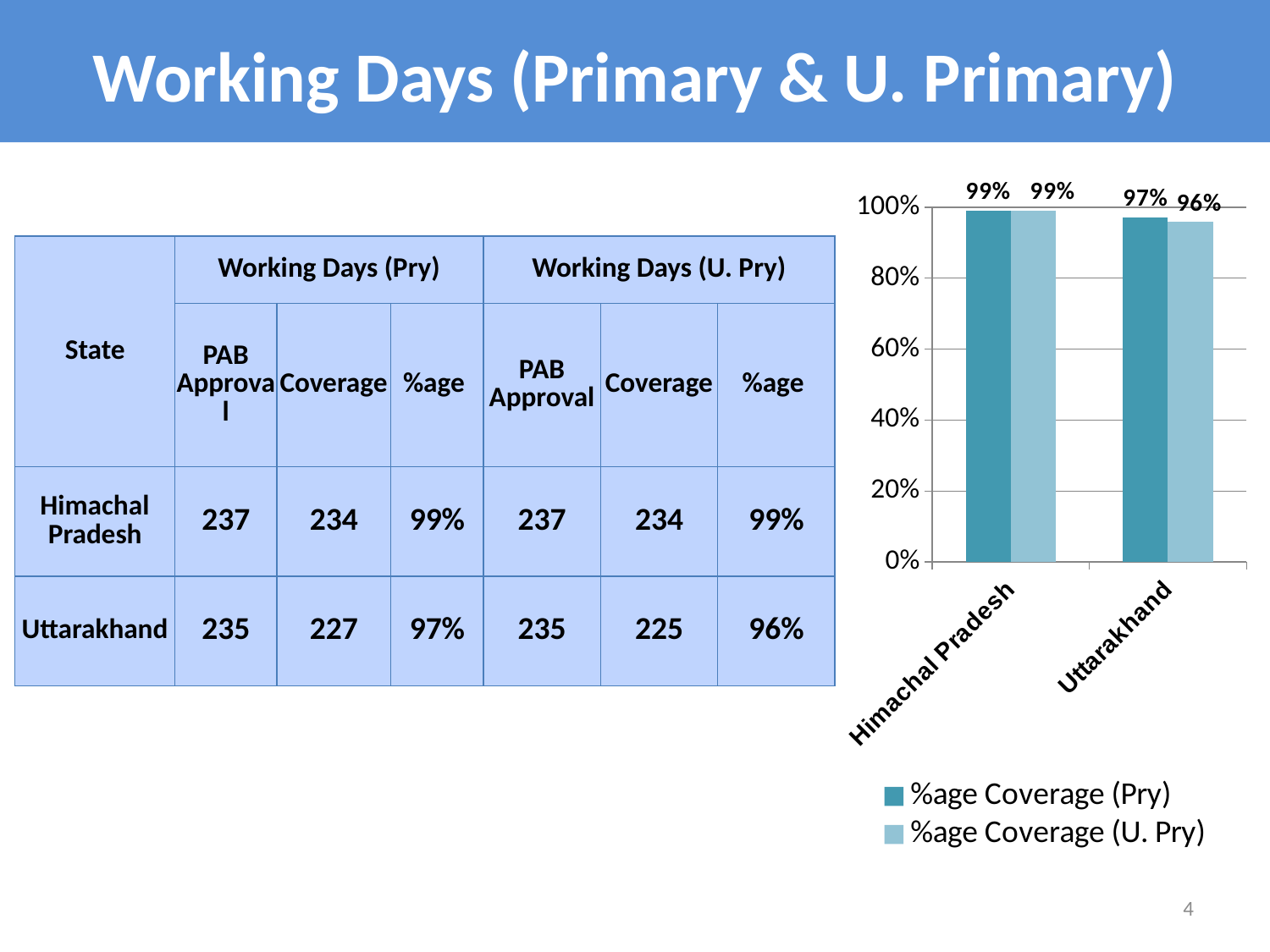
What is the %age Coverage (Pry) for Uttarakhand in the chart? 97% How many states are shown on the x axis of the chart? 2 Which state has the lower %age Coverage (U. Pry) in the chart? Uttarakhand What is the %age Coverage (Pry) for Himachal Pradesh in the chart? 99% How many series does the chart legend list? 2 Which is larger for Uttarakhand: %age Coverage (Pry) or %age Coverage (U. Pry)? %age Coverage (Pry) What type of chart is shown on the slide? bar chart What is the highest value labelled on the chart's y axis? 100% What is the difference between the %age Coverage (Pry) for Himachal Pradesh and Uttarakhand? 2% Is the %age Coverage (U. Pry) for Uttarakhand greater or less than 80%? greater What is the %age Coverage (U. Pry) for Uttarakhand in the chart? 96% What are the two series named in the chart legend? %age Coverage (Pry) and %age Coverage (U. Pry)